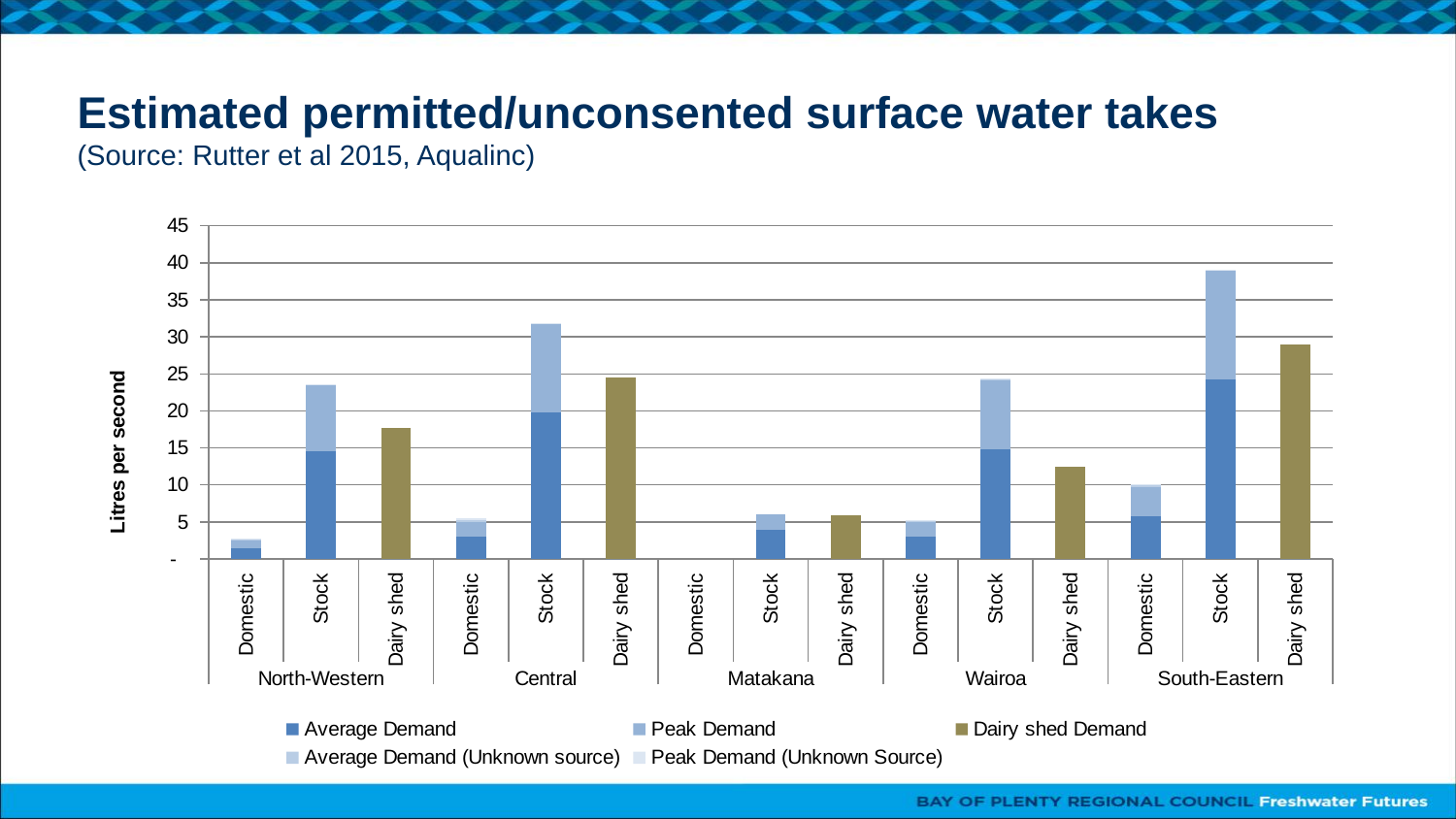
How many bars (category positions) are plotted along the x axis? 15 Is the value for North-Western Dairy shed greater or less than 20? less How many series does the legend list? 5 Which is larger, the Dairy shed value for North-Western or for Wairoa? North-Western Which bar reaches the highest total value on the chart? South-Eastern Stock Is the value for Central Dairy shed greater or less than 20? greater Is the value for Wairoa Dairy shed greater or less than 10? greater What is the label on the vertical axis? Litres per second Which is larger, the total Stock bar for Central or the total Stock bar for Wairoa? Central Which region has the tallest Dairy shed bar? South-Eastern What kind of chart is shown on the slide? Stacked bar chart